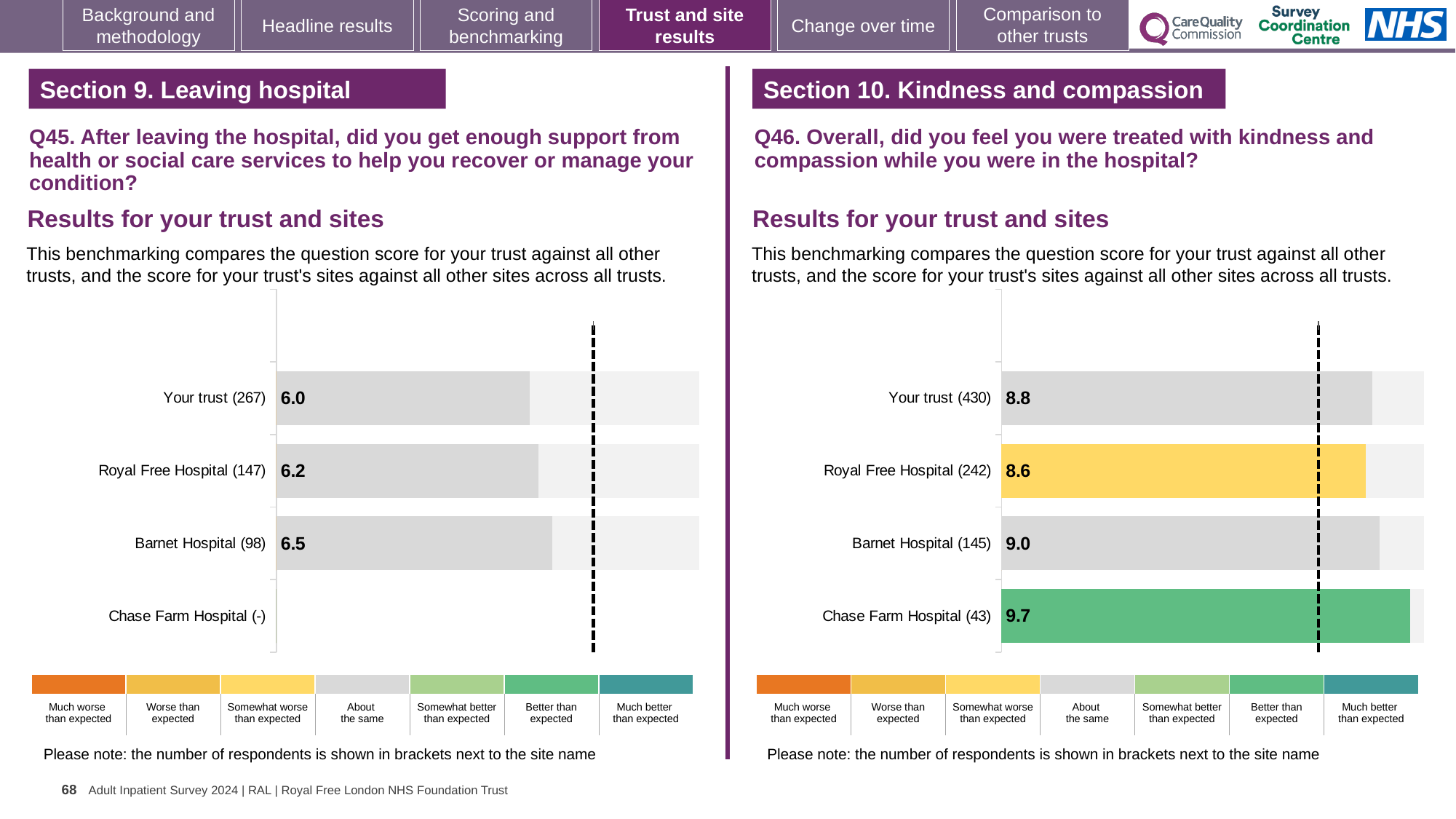
In the Q46 chart on the right, what is the score for Royal Free Hospital? 8.6 In the Q46 chart on the right, which site has the highest score? Chase Farm Hospital In the Q45 chart on the left, what is the score for Barnet Hospital? 6.5 In the Q45 chart on the left, which row with a plotted value has the lowest score? Your trust What type of chart is used on the left for Q45? Bar chart In the Q46 chart on the right, what is the difference between the scores for Chase Farm Hospital and Royal Free Hospital? 1.1 In the Q46 chart on the right, which benchmark category does the colour of the Chase Farm Hospital bar correspond to? Better than expected In the Q46 chart on the right, which row has the lowest score? Royal Free Hospital In the Q46 chart on the right, which has the higher score, Barnet Hospital or Your trust? Barnet Hospital In the Q45 chart on the left, what is the difference between the scores for Barnet Hospital and Your trust? 0.5 In the Q46 chart on the right, what is the score for Chase Farm Hospital? 9.7 In the Q45 chart on the left, what is the score for Your trust? 6.0